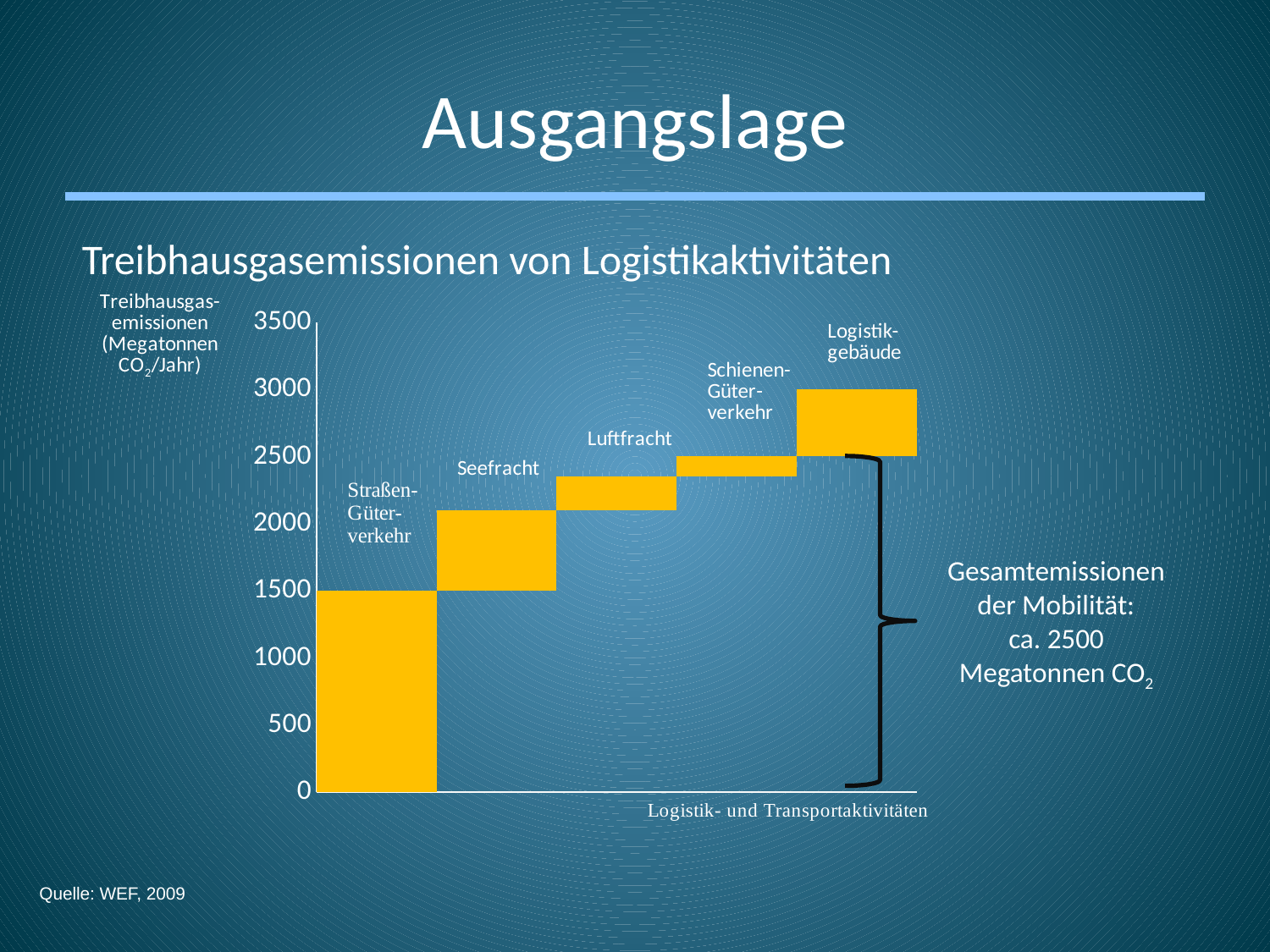
How many logistics activity categories are shown in the chart? 5 According to the annotation next to the chart, what are the total emissions of mobility? ca. 2500 Megatonnen CO2 Is the emissions contribution of Seefracht greater or less than 1000? less What kind of chart is shown on the slide? bar chart Which contributes more emissions, Logistikgebäude or Schienen-Güterverkehr? Logistikgebäude Do the cumulative emissions rise or fall from left to right across the chart? rise What is the title of the chart? Treibhausgasemissionen von Logistikaktivitäten Which category contributes the largest amount of greenhouse gas emissions in the chart? Straßen-Güterverkehr Which category contributes the smallest amount of greenhouse gas emissions in the chart? Schienen-Güterverkehr Is the value for Straßen-Güterverkehr greater or less than 1000? greater What value does the Straßen-Güterverkehr bar reach on the y axis? 1500 Which contributes more emissions, Seefracht or Luftfracht? Seefracht